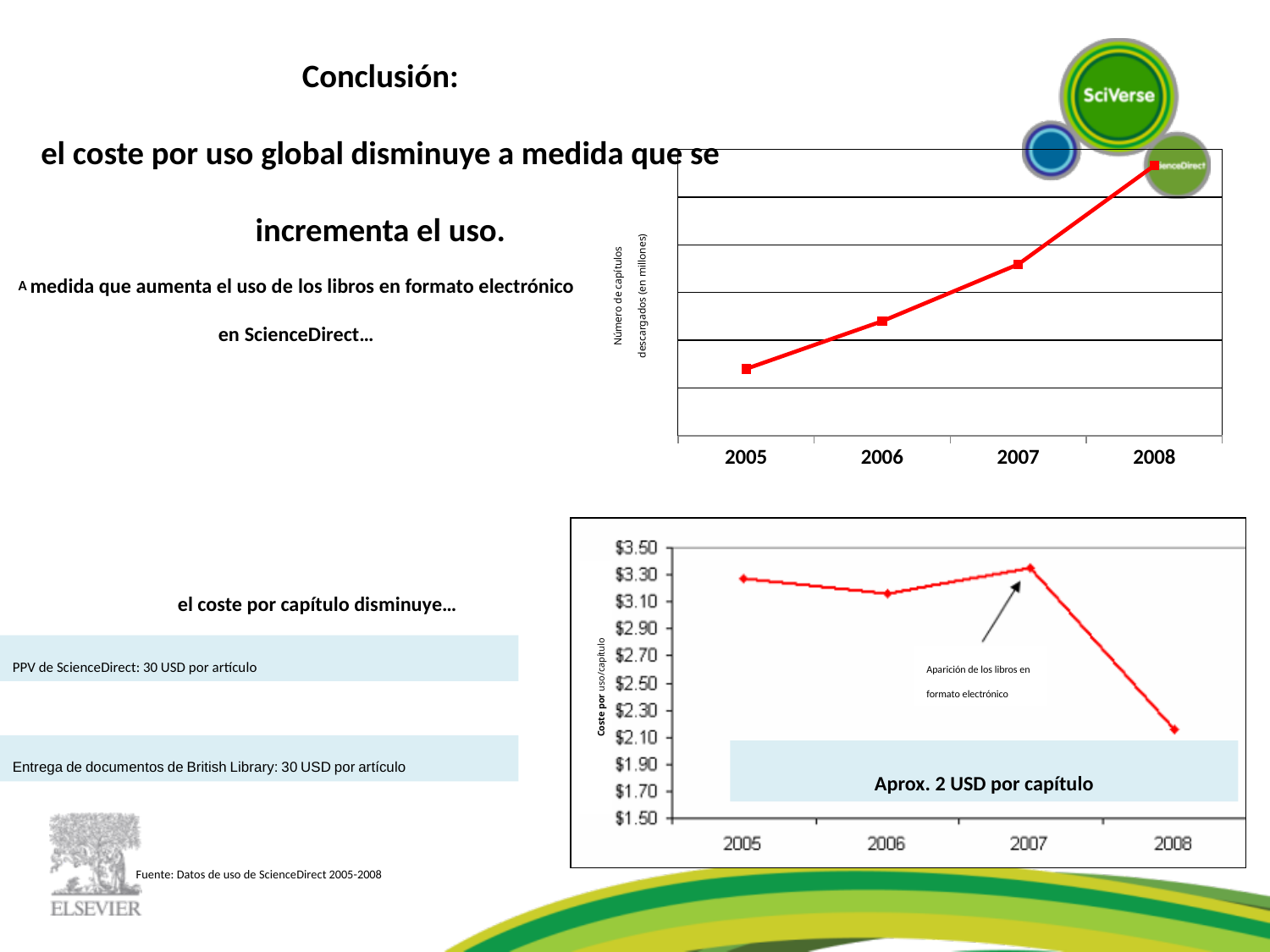
In the bottom chart (Coste por uso/capítulo), what is the highest value shown on the y axis? $3.50 What kind of chart is the top chart (Número de capítulos descargados)? line chart In the top chart (Número de capítulos descargados), which year has the highest value? 2008 What kind of chart is the bottom chart (Coste por uso/capítulo)? line chart In the bottom chart (Coste por uso/capítulo), is the value for 2008 greater or less than $2.50? less In the top chart (Número de capítulos descargados), how many years are plotted on the x axis? 4 In the bottom chart (Coste por uso/capítulo), which is larger, the value for 2007 or the value for 2008? 2007 In the top chart (Número de capítulos descargados), which year has the lowest value? 2005 In the top chart (Número de capítulos descargados), do the values rise or fall from 2005 to 2008? rise In the bottom chart (Coste por uso/capítulo), which year has the lowest cost per chapter? 2008 In the bottom chart (Coste por uso/capítulo), which year does the annotation 'Aparición de los libros en formato electrónico' point to? 2007 In the bottom chart (Coste por uso/capítulo), is the value for 2005 greater or less than $3.10? greater